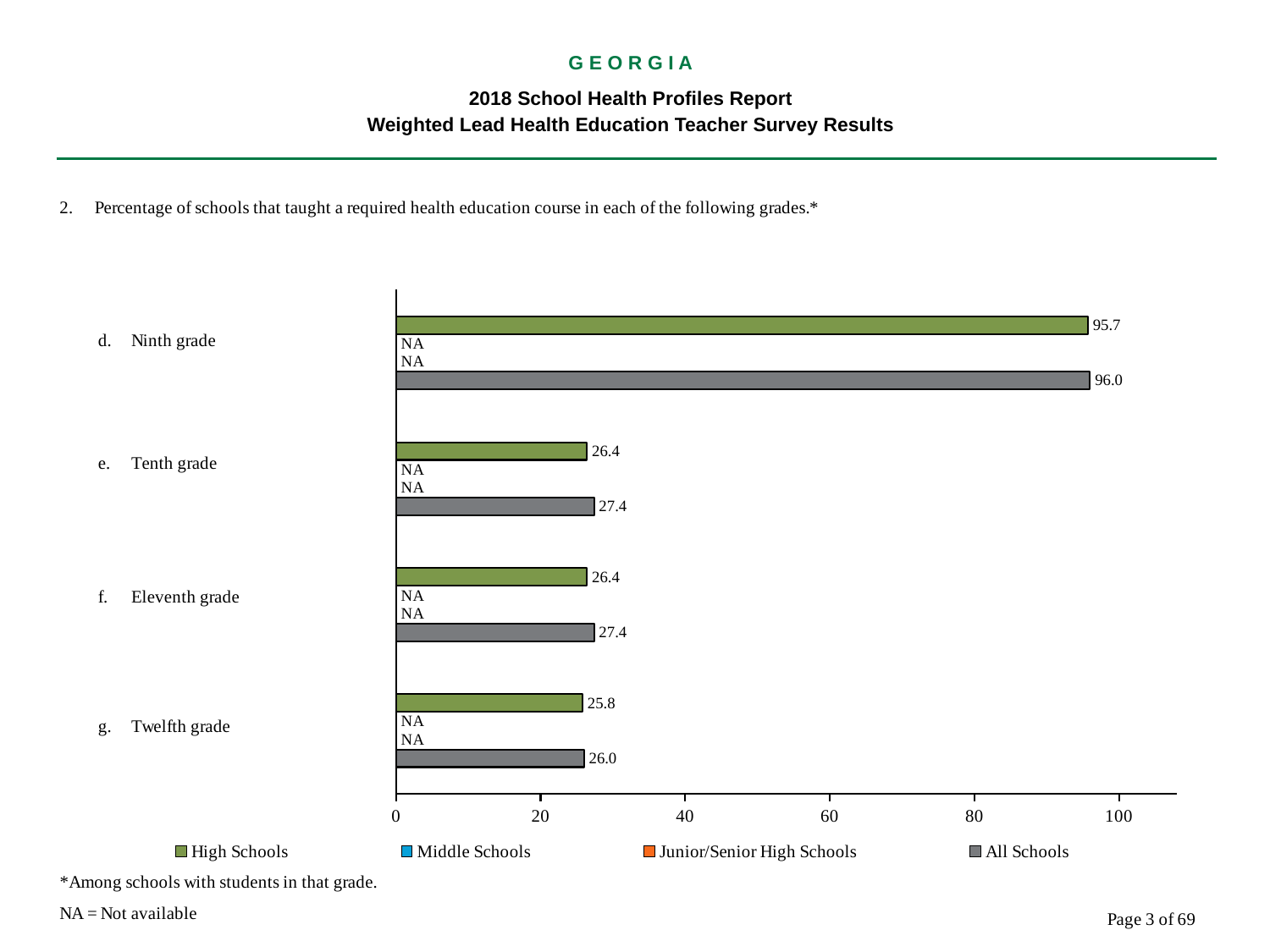
What is the difference between the High Schools values for Ninth grade and Tenth grade? 69.3 What is the value for All Schools in Tenth grade? 27.4 Which grade has the highest value for High Schools? Ninth grade Which grade has the lowest value for All Schools? Twelfth grade What is the difference between the All Schools and High Schools values for Ninth grade? 0.3 Is the value for High Schools in Ninth grade greater or less than 80? greater Which is larger for Eleventh grade: the High Schools value or the All Schools value? All Schools What is the value for High Schools in Ninth grade? 95.7 How many series does the legend list? 4 What is the value for All Schools in Twelfth grade? 26.0 How many grade categories are shown in the chart? 4 What kind of chart is shown on the slide? Bar chart